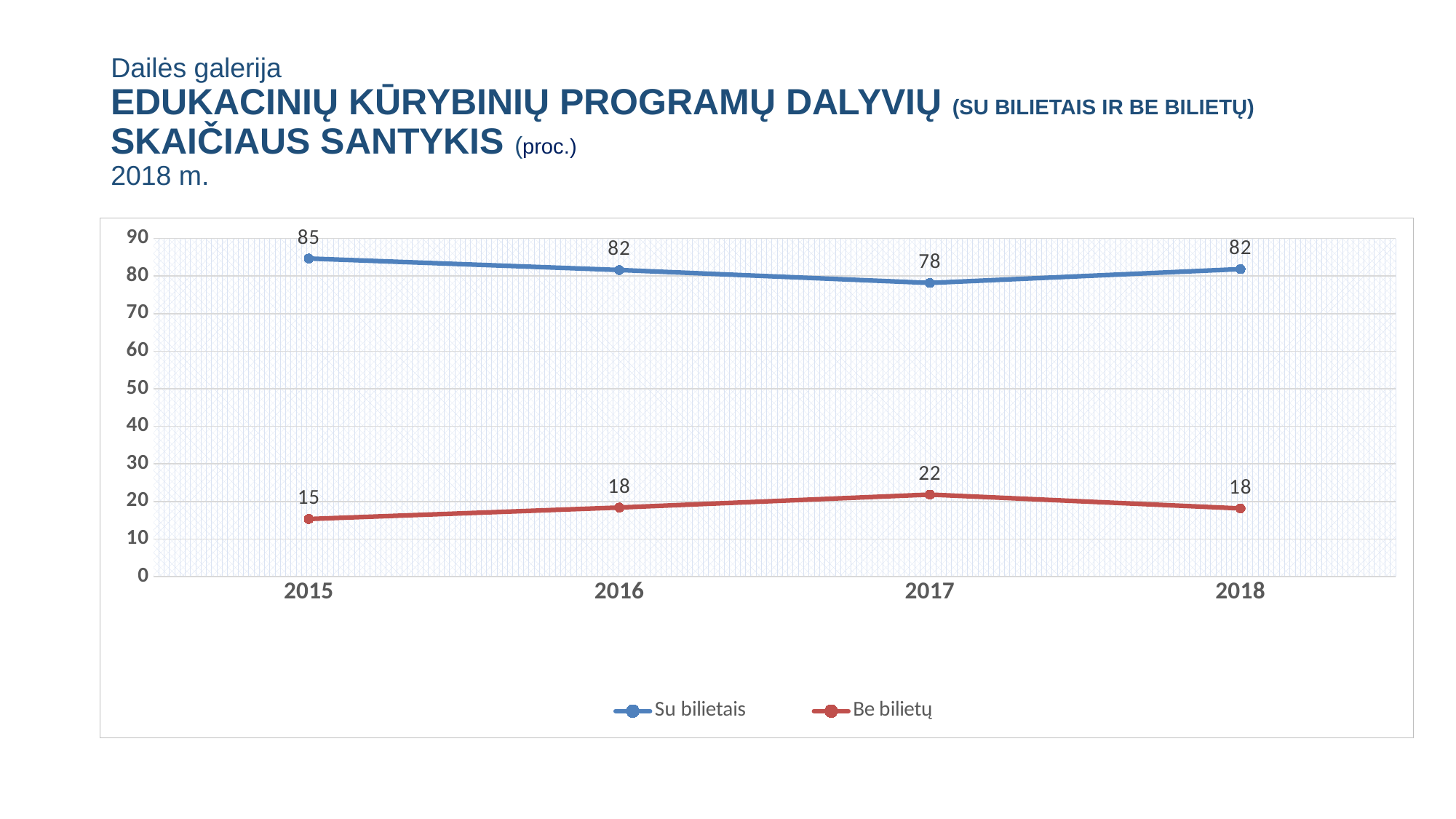
Which is larger in 2016: Su bilietais or Be bilietų? Su bilietais In which year is the Su bilietais value lowest? 2017 What is the value for Be bilietų in 2017? 22 How many years are shown on the x axis? 4 What is the value for Be bilietų in 2018? 18 What kind of chart is shown on the slide? Line chart In which year is the Be bilietų value highest? 2017 What is the value for Su bilietais in 2015? 85 How many series does the legend list? 2 What is the difference between the Su bilietais values in 2015 and 2017? 7 What is the difference between the Su bilietais and Be bilietų values in 2015? 70 What is the value for Su bilietais in 2017? 78